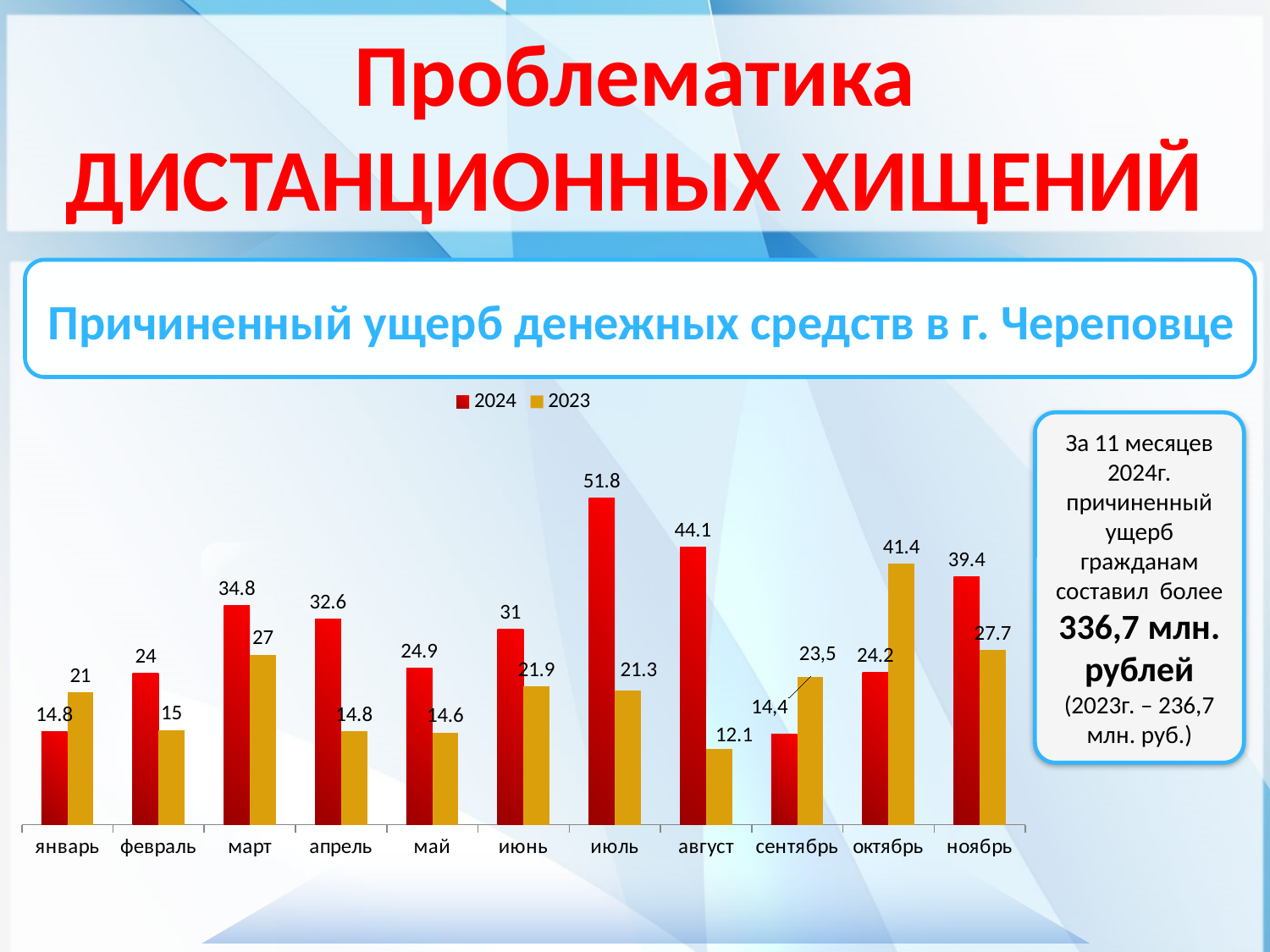
How many series does the chart legend list? 2 What is the difference between the 2024 and 2023 values in июль (July)? 30.5 In which month is the 2024 value the highest? июль What is the value for 2023 in октябрь (October)? 41.4 How many months are shown along the x axis of the chart? 11 What is the value for 2024 in июль (July)? 51.8 What type of chart is shown on the slide? bar chart Which is larger in октябрь (October): the 2024 value or the 2023 value? 2023 Which colour represents the 2024 series in the chart? red In which month is the 2023 value the lowest? август Which is larger in август (August): the 2024 value or the 2023 value? 2024 What is the value for 2024 in сентябрь (September)? 14,4